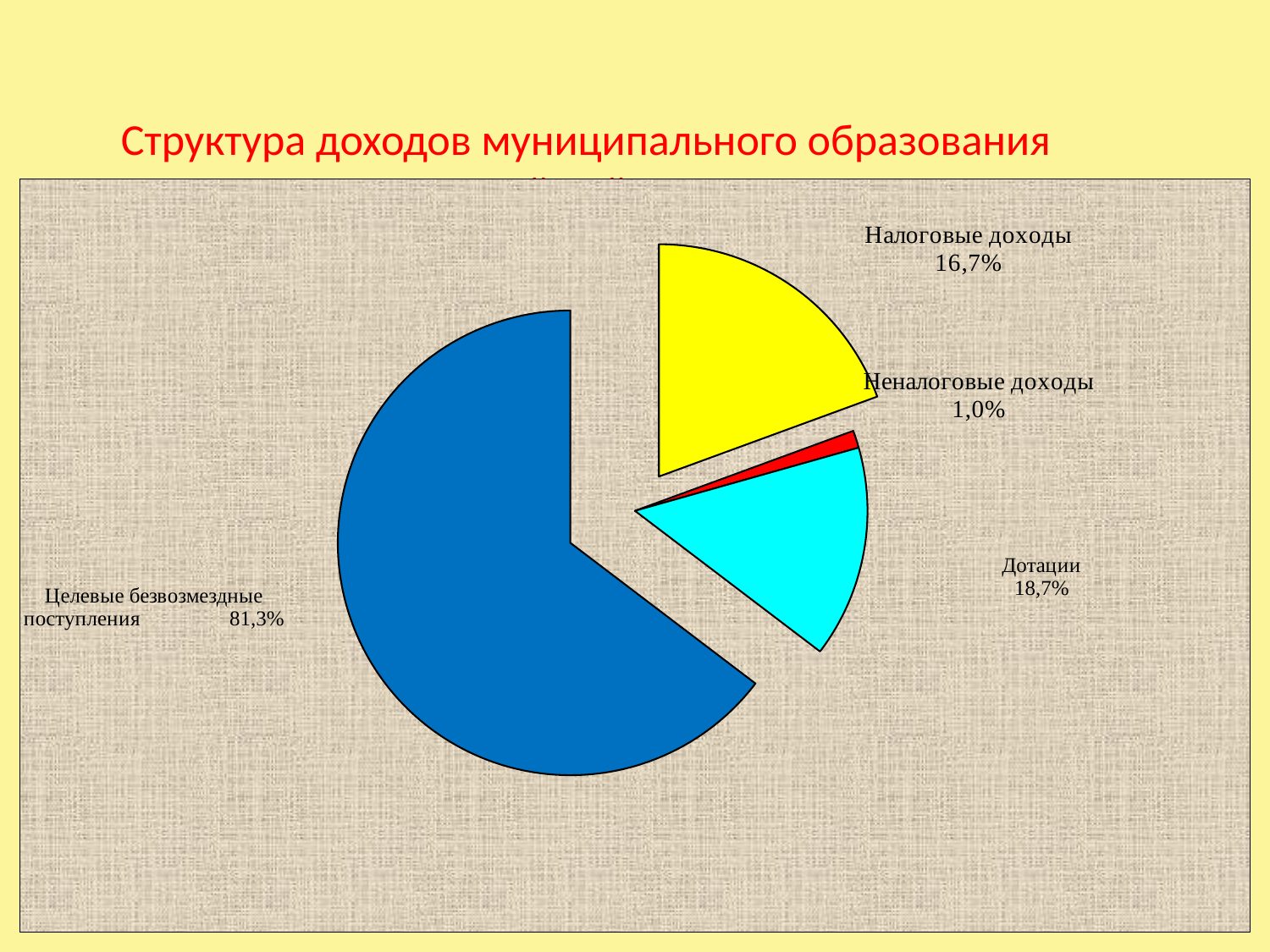
What is the title of the slide? Структура доходов муниципального образования What colour is the slice for Целевые безвозмездные поступления? blue What is the difference between the shares for Дотации and Налоговые доходы? 2,0% What is the share for Дотации? 18,7% What is the share for Налоговые доходы? 16,7% What is the share for Целевые безвозмездные поступления? 81,3% What is the share for Неналоговые доходы? 1,0% Which category has the largest slice of the pie? Целевые безвозмездные поступления What kind of chart is shown on the slide? pie chart Which category has the smallest slice of the pie? Неналоговые доходы How many slices does the pie chart have? 4